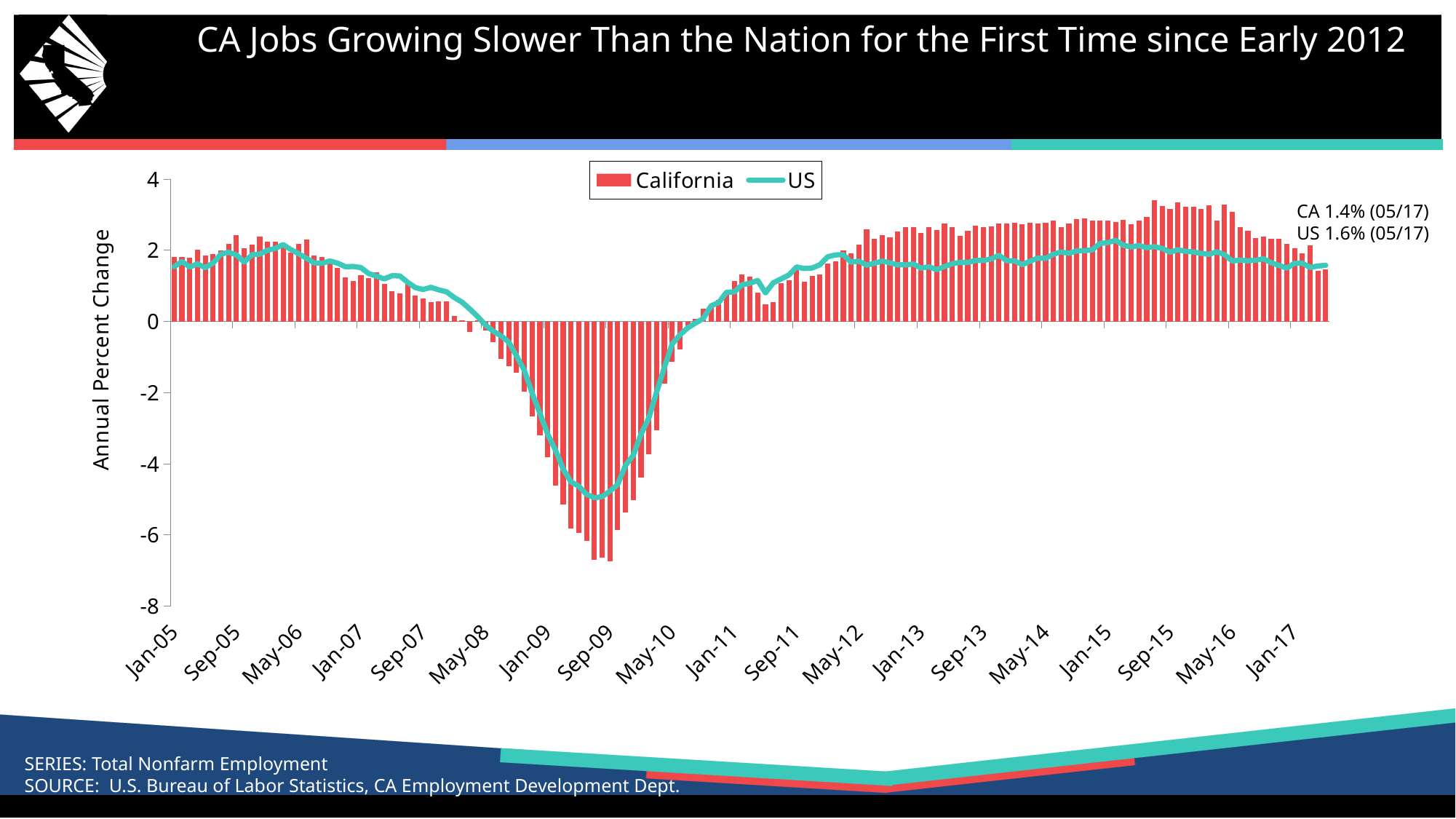
What is the annotated value for California in 05/17? 1.4% In 05/17, which is larger, the California value or the US value? US How many series does the legend list? 2 What is the difference between the US and California values annotated for 05/17? 0.2 percentage points What is the title of the vertical axis? Annual Percent Change Which series reaches the lower trough in 2009, California or US? California What is the annotated value for the US in 05/17? 1.6% Do the California values rise or fall between Jan-09 and Sep-09? fall Is the value for the US at Sep-09 greater or less than -4? less Is the value for California at Sep-15 greater or less than 2? greater Is the value for California at Sep-09 greater or less than -6? less What kind of chart is shown on the slide? A bar chart combined with a line chart